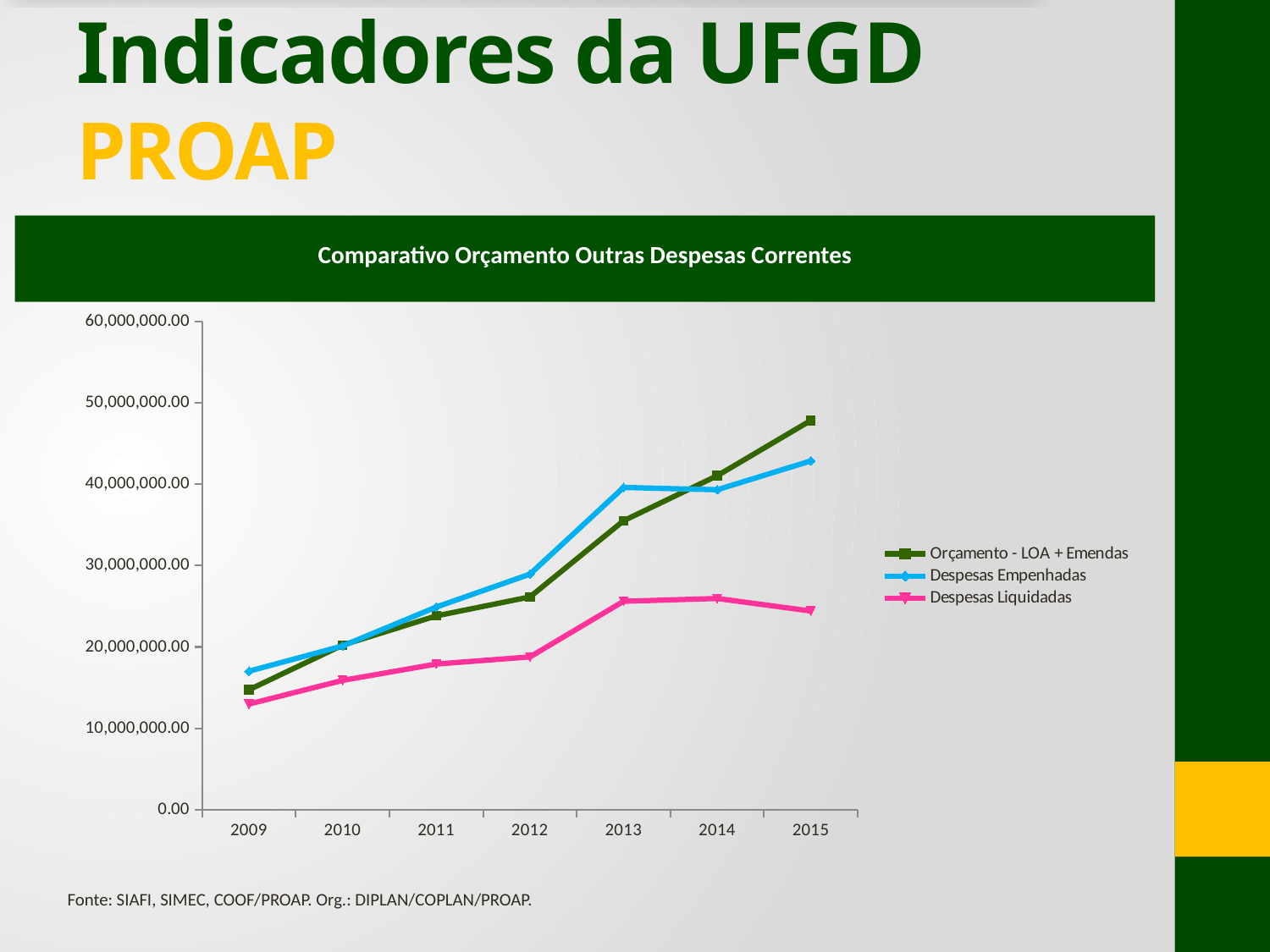
Is the value for Despesas Liquidadas in 2009 greater or less than 20,000,000.00? less In which year is Orçamento - LOA + Emendas highest? 2015 Does Orçamento - LOA + Emendas rise or fall from 2009 to 2015? Rise How many series does the legend list? 3 What is the title of the chart? Comparativo Orçamento Outras Despesas Correntes Is the value for Despesas Empenhadas in 2012 greater or less than 30,000,000.00? less In 2015, which is larger: Orçamento - LOA + Emendas or Despesas Empenhadas? Orçamento - LOA + Emendas What kind of chart is shown on the slide? Line chart How many years are shown on the x axis? 7 Is the value for Orçamento - LOA + Emendas in 2015 greater or less than 40,000,000.00? greater In 2013, which is larger: Despesas Empenhadas or Orçamento - LOA + Emendas? Despesas Empenhadas In which year is Despesas Liquidadas lowest? 2009